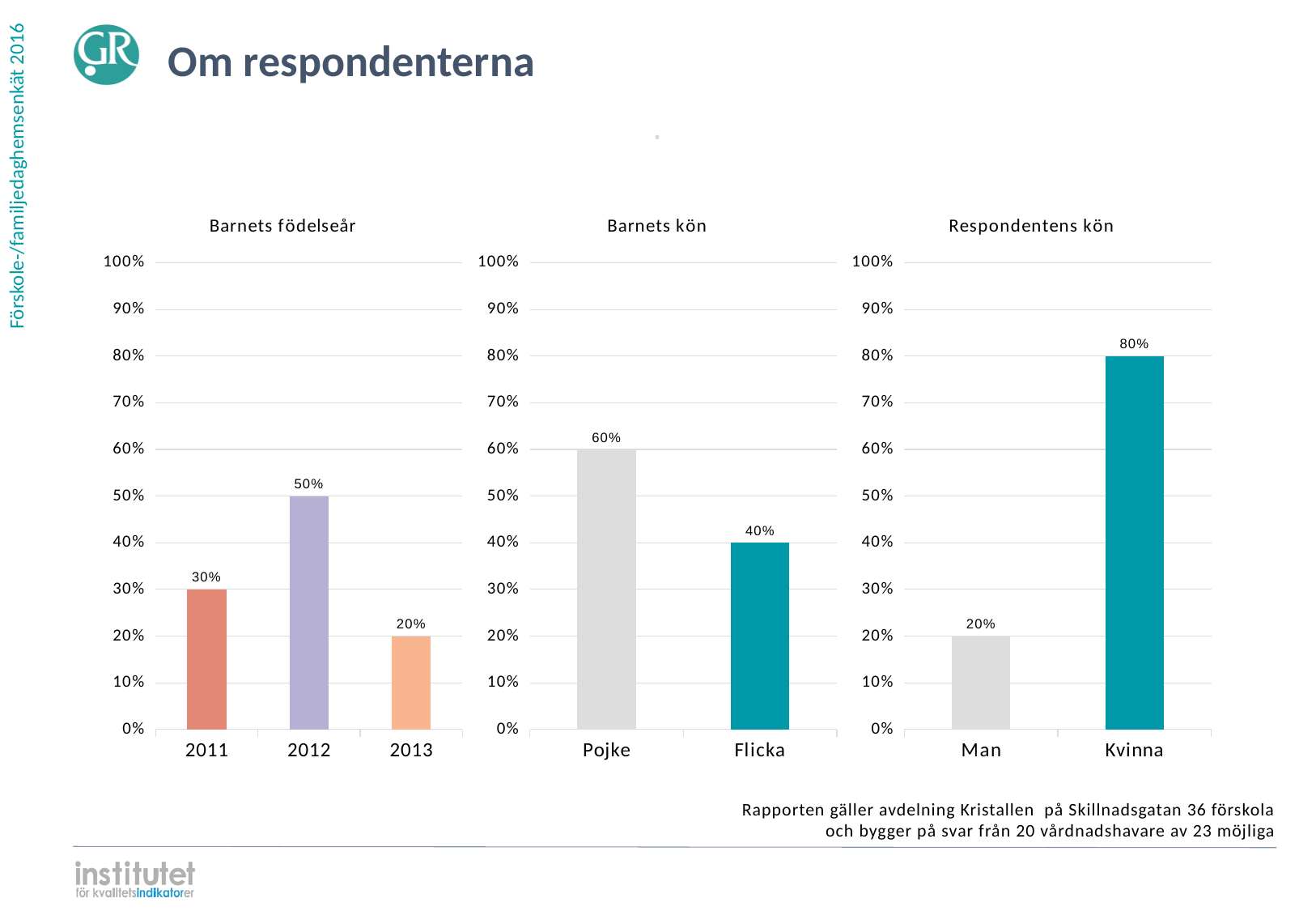
In the 'Barnets kön' chart, which is larger, Pojke or Flicka? Pojke In the 'Respondentens kön' chart, which category has the highest value? Kvinna In the 'Barnets födelseår' chart, how many categories are shown on the x axis? 3 In the 'Barnets födelseår' chart, what is the difference between the values for 2012 and 2011? 20% In the 'Barnets kön' chart, what is the difference between Pojke and Flicka? 20% In the 'Barnets födelseår' chart, which year has the lowest value? 2013 In the 'Respondentens kön' chart, what is the value for Man? 20% In the 'Respondentens kön' chart, what is the value for Kvinna? 80% How many charts are shown on the slide? 3 What kind of chart is the 'Respondentens kön' chart? Bar chart In the 'Barnets födelseår' chart, what is the value for 2012? 50% In the 'Barnets kön' chart, what is the value for Pojke? 60%